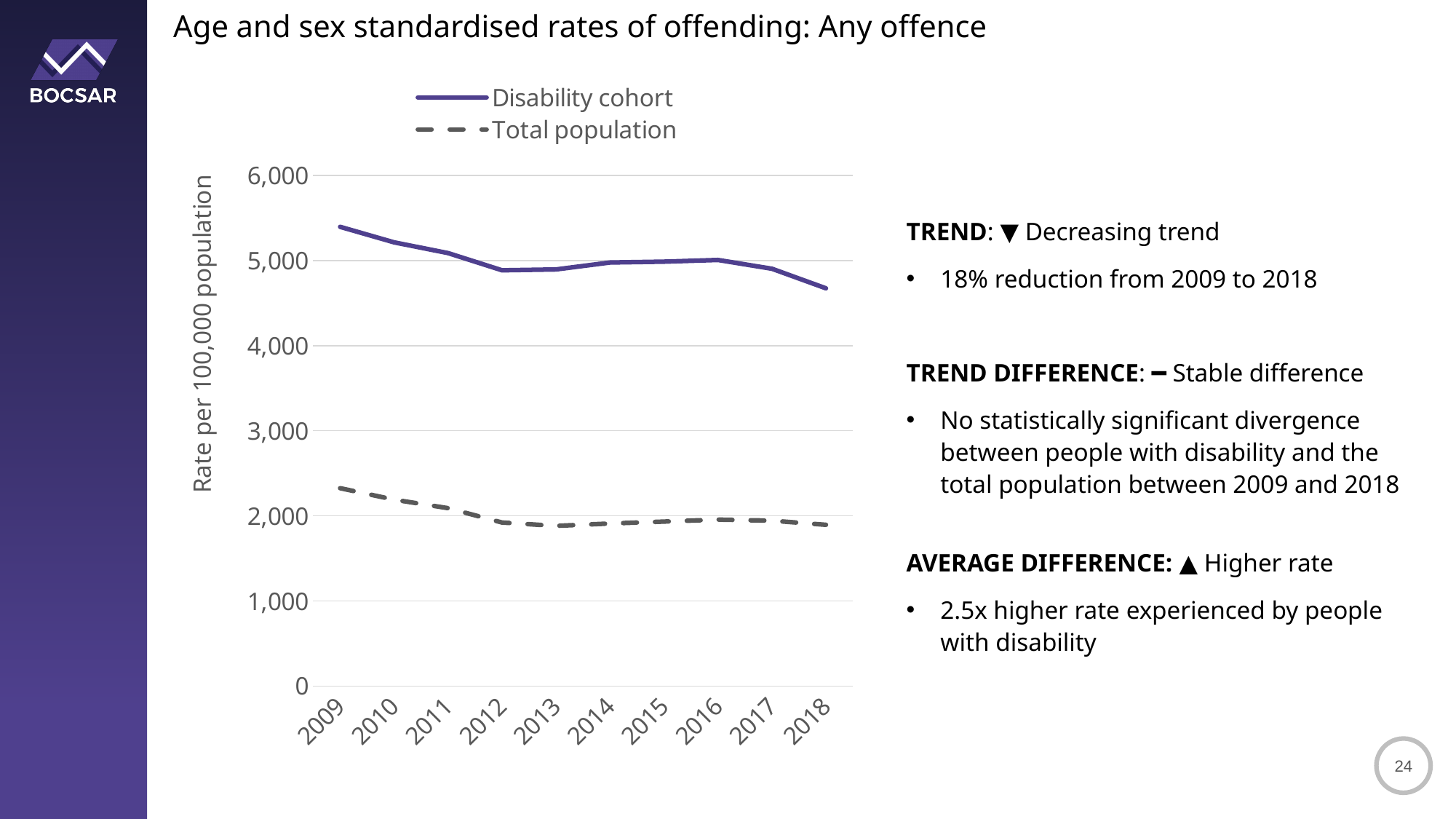
What is the label on the vertical axis? Rate per 100,000 population Is the Disability cohort value for 2018 greater or less than 5,000? less In which year is the Disability cohort rate highest? 2009 In which year is the Total population rate highest? 2009 How many years are plotted along the x axis? 10 What kind of chart is shown on the slide? line chart Is the Disability cohort value for 2009 greater or less than 5,000? greater In which year is the Disability cohort rate lowest? 2018 Which series is drawn with a dashed line? Total population How many series does the legend list? 2 Does the Disability cohort rate rise or fall from 2009 to 2018? fall Which series has the higher rate in 2015, Disability cohort or Total population? Disability cohort